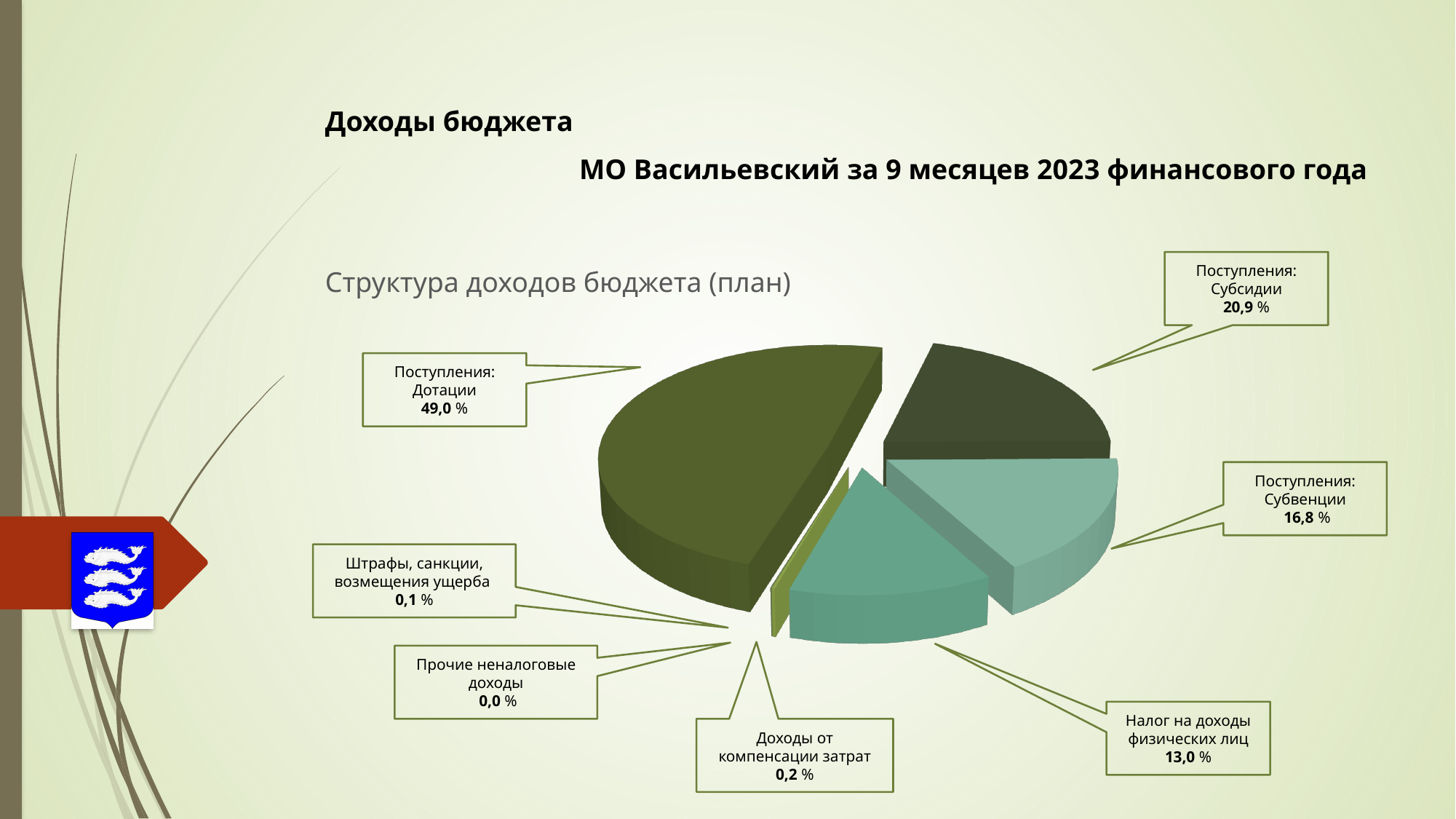
What kind of chart is shown on the slide? Pie chart What is the difference in percentage points between Поступления: Дотации and Поступления: Субсидии? 28,1 % What share of the budget revenue is Поступления: Дотации? 49,0 % What share of the budget revenue is Доходы от компенсации затрат? 0,2 % What share of the budget revenue is Поступления: Субсидии? 20,9 % Which category has the largest share of the pie? Поступления: Дотации What is the title of the chart? Структура доходов бюджета (план) How many categories are shown in the pie chart? 7 What share of the budget revenue is Налог на доходы физических лиц? 13,0 % Which is larger: Поступления: Субсидии or Поступления: Субвенции? Поступления: Субсидии What is the difference in percentage points between Поступления: Субвенции and Налог на доходы физических лиц? 3,8 % Which category has the smallest share of the pie? Прочие неналоговые доходы